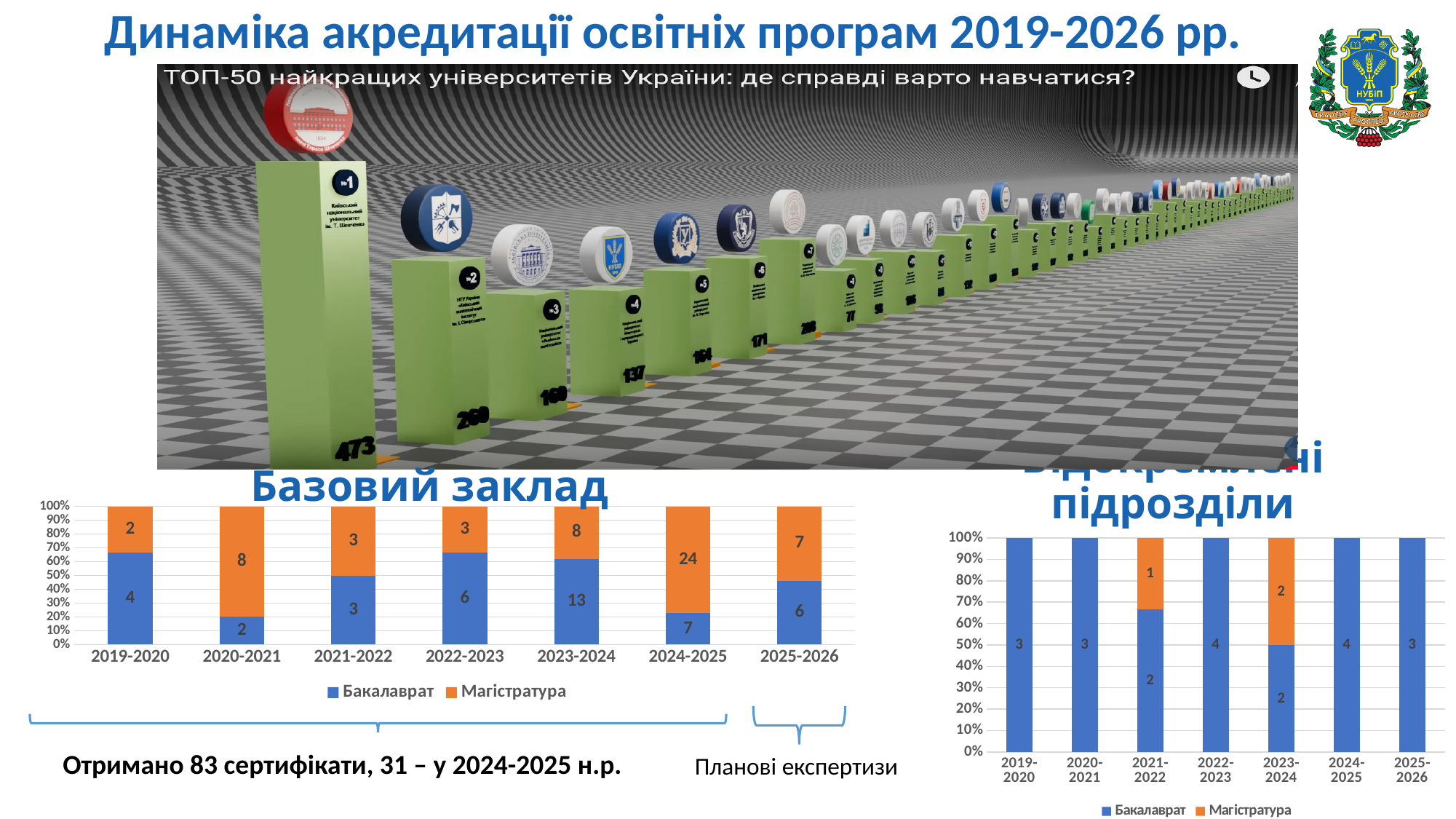
What type of chart is the right-hand chart ('Відокремлені підрозділи')? Stacked bar chart In the 'Базовий заклад' chart, which year has the lowest Бакалаврат value? 2020-2021 How many year categories are shown on the x axis of the 'Базовий заклад' chart? 7 In the 'Базовий заклад' chart, which year has the highest Магістратура value? 2024-2025 In the 'Базовий заклад' chart, what is the total of the 2023-2024 bar (Бакалаврат plus Магістратура)? 21 In the right-hand chart ('Відокремлені підрозділи'), what is the Бакалаврат value for 2022-2023? 4 In the right-hand chart ('Відокремлені підрозділи'), what is the Магістратура value for 2023-2024? 2 In the 'Базовий заклад' chart, which is larger in 2022-2023: Бакалаврат or Магістратура? Бакалаврат In the 'Базовий заклад' chart, what is the value for Магістратура in 2024-2025? 24 In the 'Базовий заклад' chart, what is the difference between the Магістратура values for 2024-2025 and 2025-2026? 17 In the 'Базовий заклад' chart, what is the value for Бакалаврат in 2023-2024? 13 How many series does the legend of the 'Базовий заклад' chart list? 2